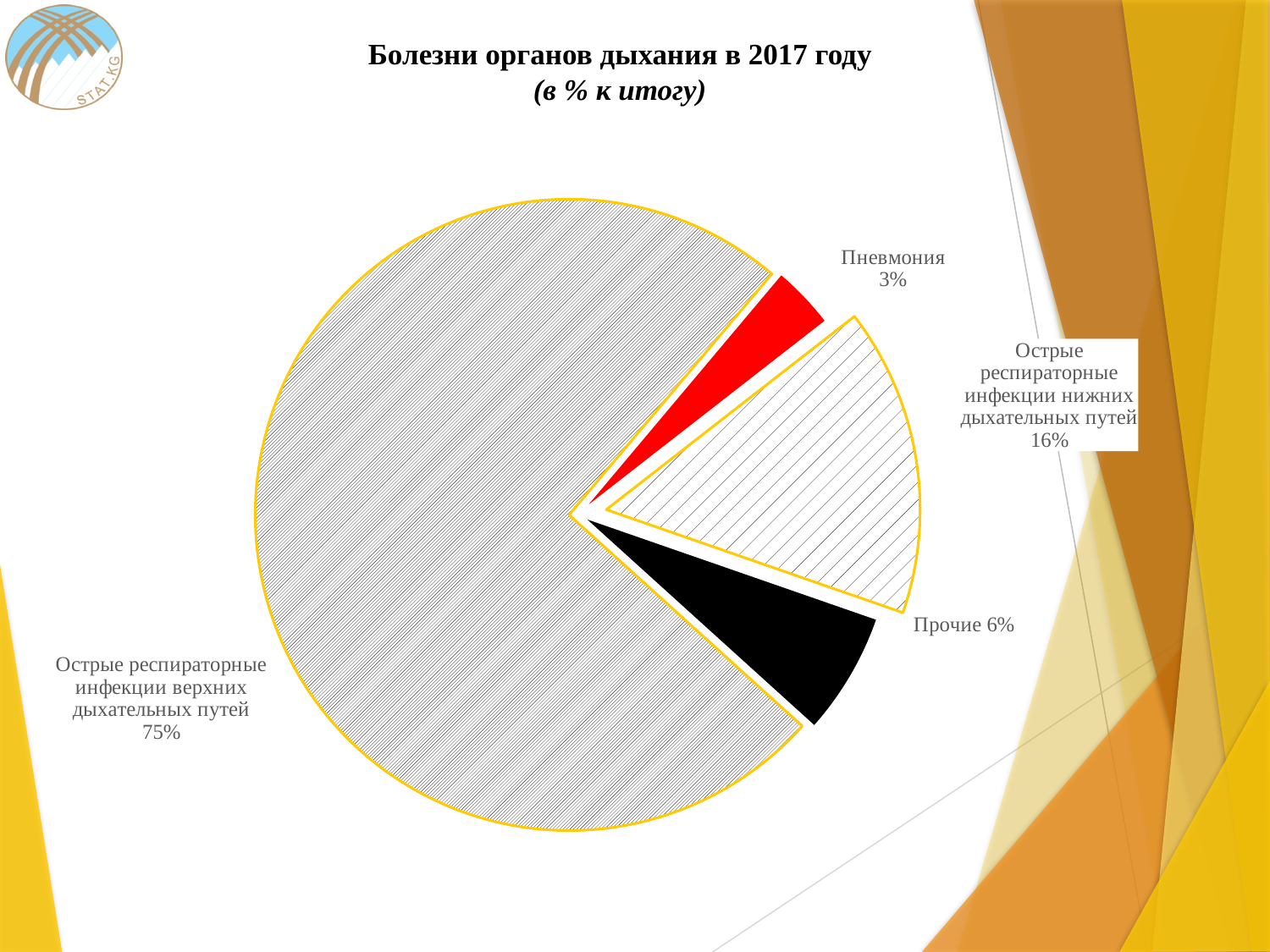
Which category has the smallest slice of the pie? Пневмония How many slices does the pie chart have? 4 Which is larger: the share for Прочие or the share for Пневмония? Прочие What colour is the slice for Пневмония? red What is the share for Острые респираторные инфекции нижних дыхательных путей? 16% What is the title of the chart? Болезни органов дыхания в 2017 году (в % к итогу) Which category has the largest slice of the pie? Острые респираторные инфекции верхних дыхательных путей What is the share for Пневмония? 3% What is the difference in percentage points between Острые респираторные инфекции нижних дыхательных путей and Прочие? 10 What kind of chart is shown on the slide? pie chart What is the share for Прочие? 6% What is the share for Острые респираторные инфекции верхних дыхательных путей? 75%